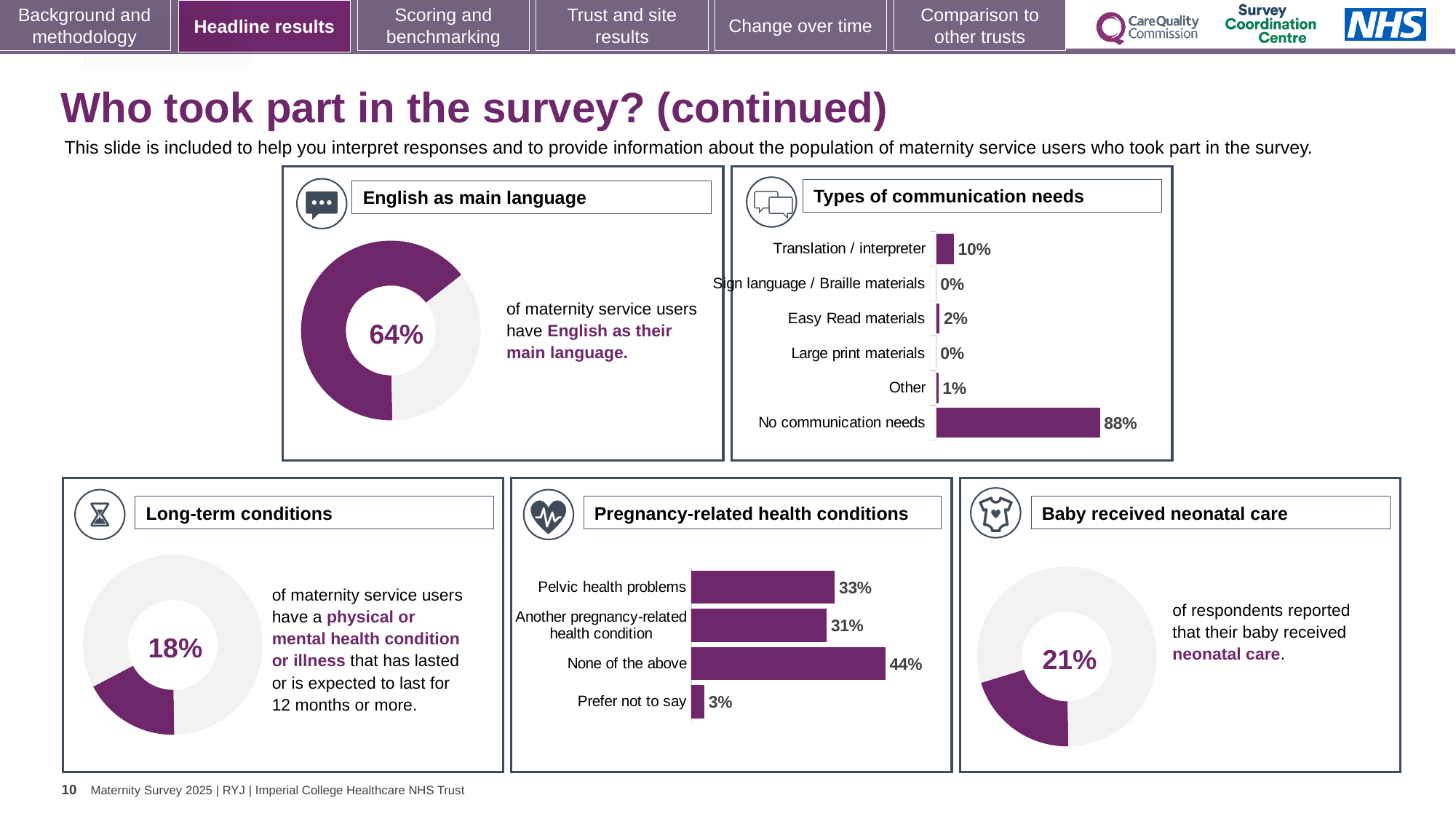
In the 'Baby received neonatal care' chart, what percentage of respondents reported that their baby received neonatal care? 21% In the 'Types of communication needs' chart, which category has the highest value? No communication needs In the 'Pregnancy-related health conditions' chart, which is larger: None of the above or Another pregnancy-related health condition? None of the above In the 'Pregnancy-related health conditions' chart, what is the difference between None of the above and Prefer not to say? 41% In the 'Types of communication needs' chart, what is the difference between No communication needs and Translation / interpreter? 78% In the 'Pregnancy-related health conditions' chart, what is the value for Pelvic health problems? 33% In the 'English as main language' chart, what share of maternity service users have English as their main language? 64% How many categories are shown in the 'Types of communication needs' chart? 6 What kind of chart is used in the 'Pregnancy-related health conditions' panel? Bar chart In the 'Pregnancy-related health conditions' chart, which category has the lowest value? Prefer not to say In the 'Types of communication needs' chart, what is the value for Translation / interpreter? 10% In the 'Long-term conditions' chart, what percentage of maternity service users have a physical or mental health condition or illness? 18%